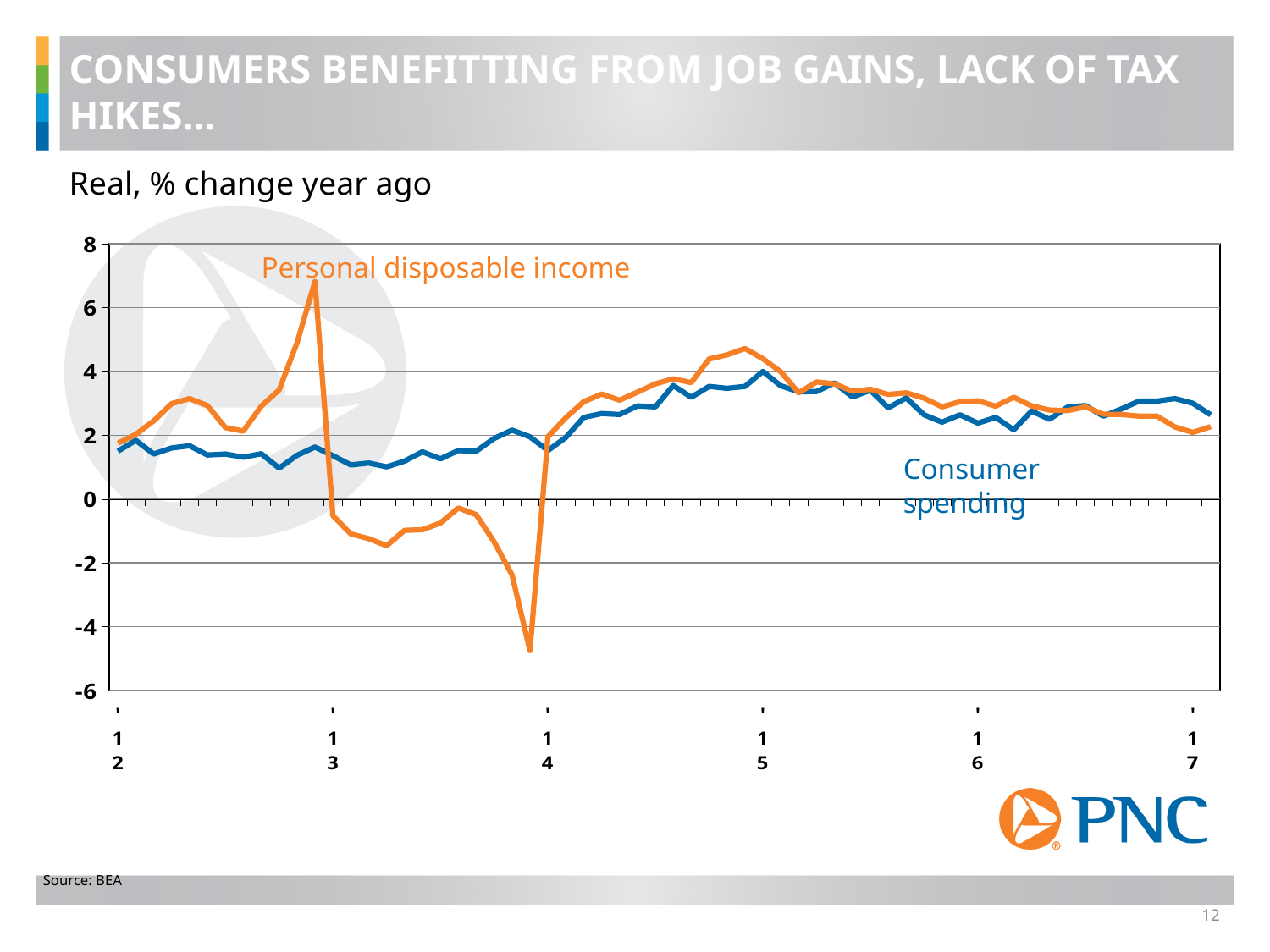
What are the names of the two series plotted on the chart? Personal disposable income and Consumer spending Which series reaches the higher peak value on the chart? Personal disposable income How many year labels are shown on the x axis? 6 Is the highest value reached by Personal disposable income greater or less than 6? greater What is the subtitle describing the units of the chart? Real, % change year ago Is the highest value of Consumer spending greater or less than 6? less At the start of 2014 (x-axis label 14), which series has the lower value? Consumer spending Is the lowest value of Consumer spending greater or less than 0? greater How many data series are plotted on the chart? 2 What kind of chart is shown on the slide? line chart Between the x-axis labels 12 and 15, does Consumer spending generally rise or fall? rise